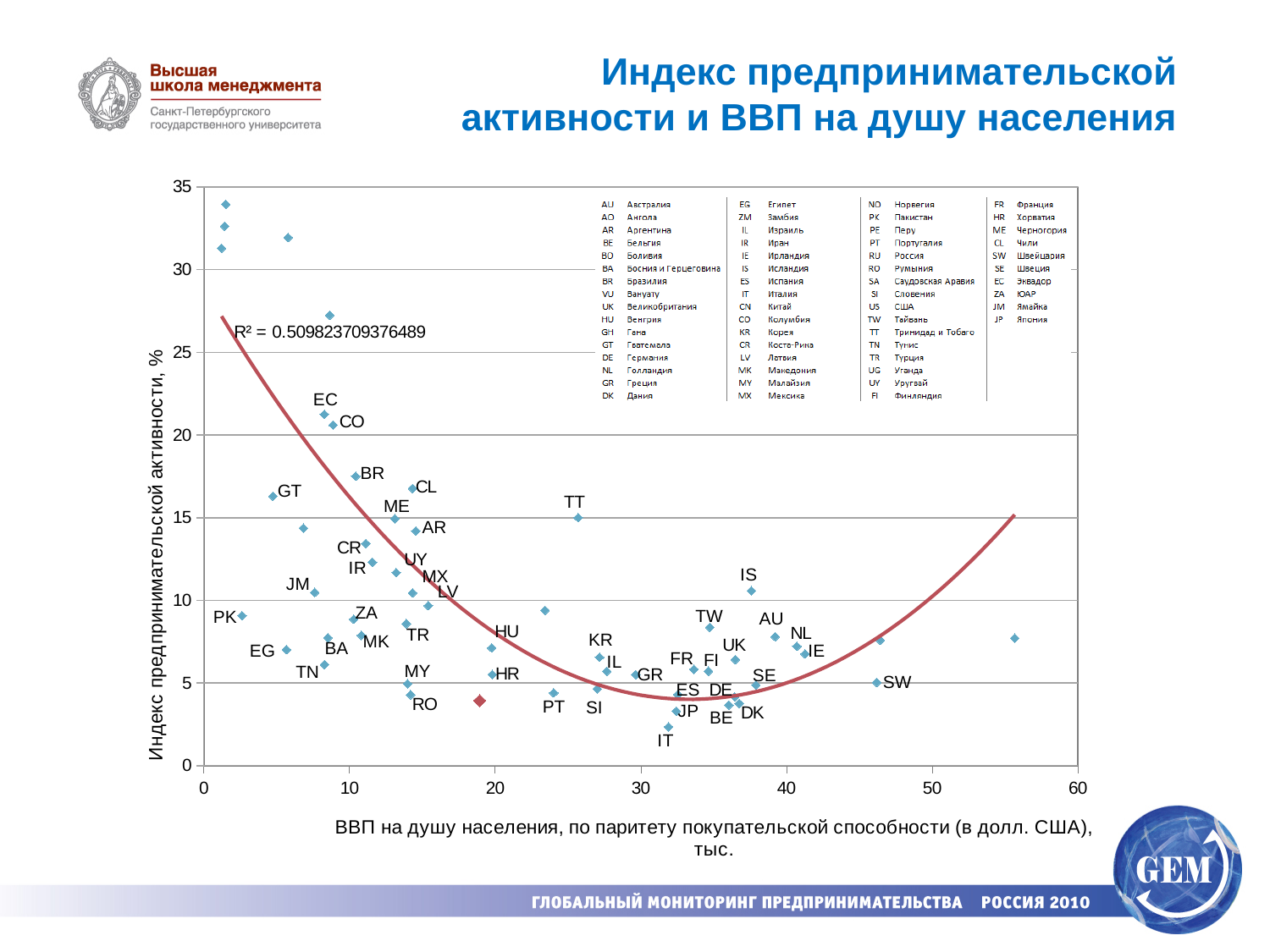
Is the entrepreneurial activity index for PK greater or less than 10? less Is the entrepreneurial activity index for IT greater or less than 5? less Which has a higher entrepreneurial activity index, GT or EG? GT Is the entrepreneurial activity index for EC greater or less than 20? greater What is the R² value printed on the chart? 0.509823709376489 Which has a higher entrepreneurial activity index, EC or IT? EC What kind of chart is shown on the slide? scatter chart Does the fitted trend line fall or rise as GDP per capita increases from 0 to 30? falls Among the labeled countries, which has the lowest entrepreneurial activity index? IT What is the label of the x axis? ВВП на душу населения, по паритету покупательской способности (в долл. США), тыс.